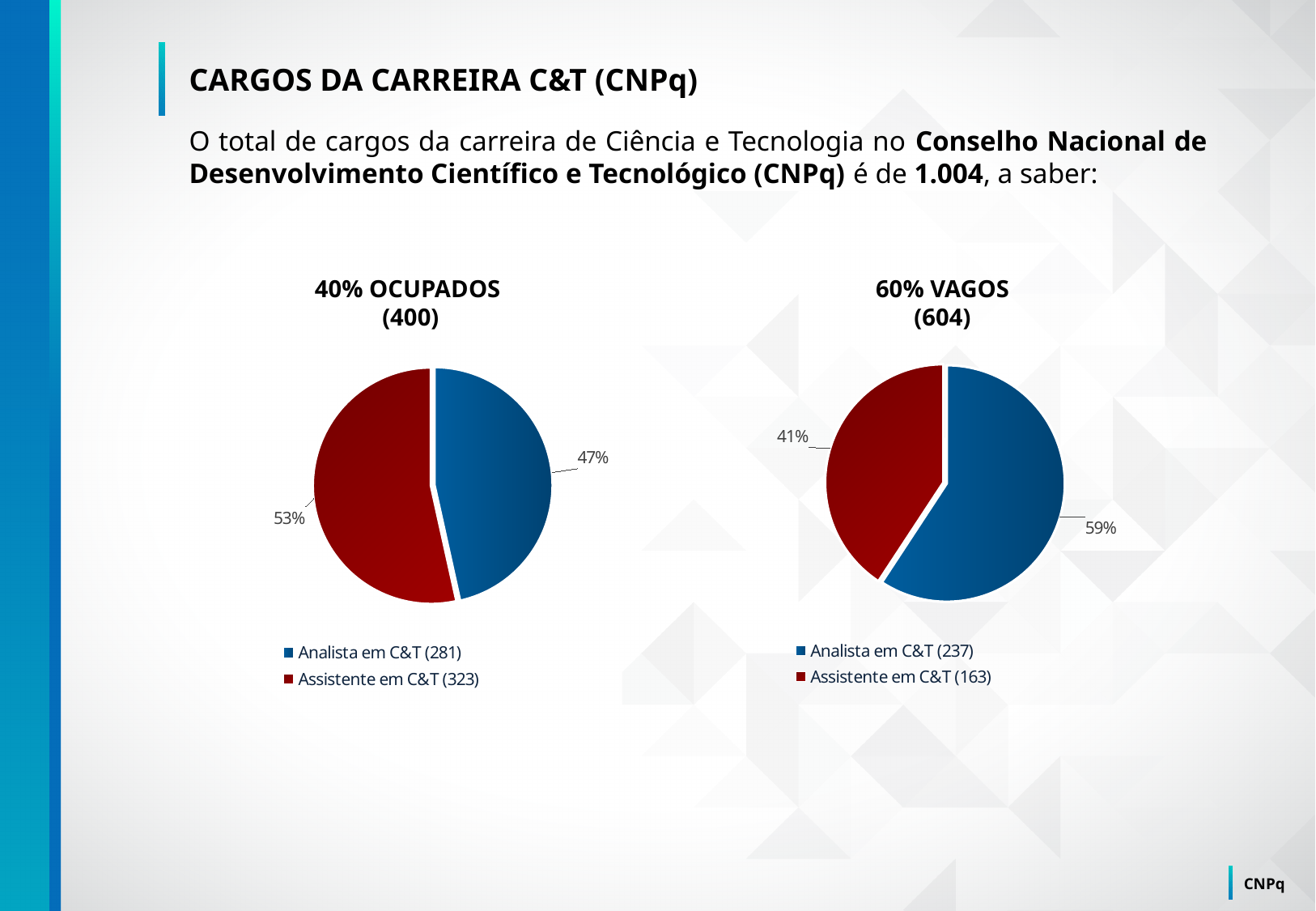
In the "40% OCUPADOS (400)" chart, which slice is larger, Analista em C&T or Assistente em C&T? Assistente em C&T In the "60% VAGOS (604)" chart, which slice is the largest? Analista em C&T In the "40% OCUPADOS (400)" chart, what share does the Assistente em C&T slice have? 53% In the "40% OCUPADOS (400)" chart, what share does the Analista em C&T slice have? 47% In the "60% VAGOS (604)" chart, what share does the Assistente em C&T slice have? 41% What kind of chart is the "40% OCUPADOS (400)" chart? pie chart In the "60% VAGOS (604)" chart, what is the difference in percentage points between the Analista em C&T and Assistente em C&T slices? 18 What is the title of the pie chart on the left of the slide? 40% OCUPADOS (400) How many slices does the "40% OCUPADOS (400)" pie chart have? 2 In the "60% VAGOS (604)" chart, what colour is the Assistente em C&T slice? red How many entries does the legend of the "60% VAGOS (604)" chart list? 2